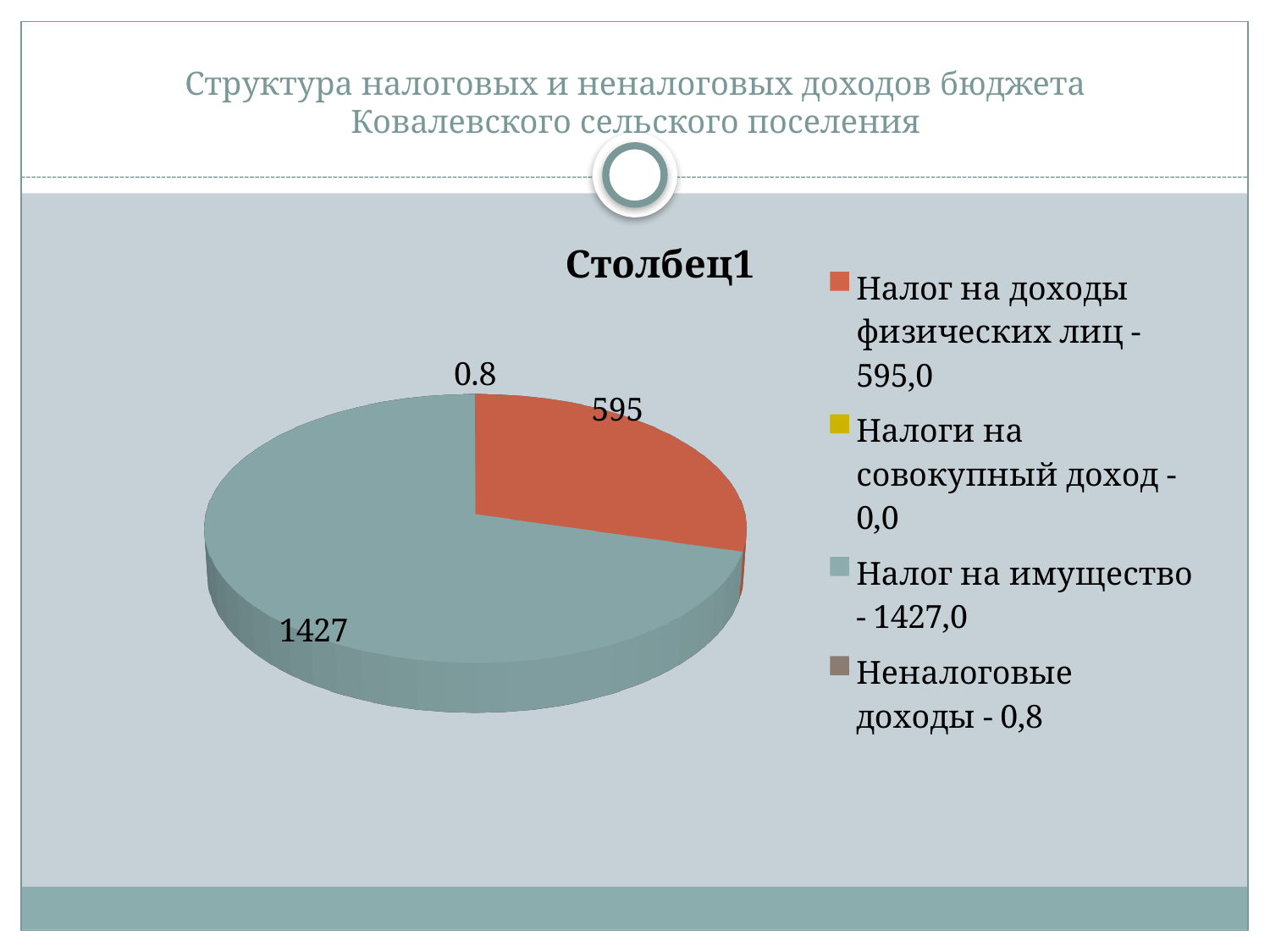
How many entries does the chart legend list? 4 Which category has the largest value? Налог на имущество What is the value for Налог на имущество? 1427,0 What is the value for Налог на доходы физических лиц? 595,0 What is the value for Налоги на совокупный доход? 0,0 Which category has the smallest value according to the legend? Налоги на совокупный доход What colour is the slice for Налог на доходы физических лиц? Red (orange-red) Which is larger: Налог на доходы физических лиц or Неналоговые доходы? Налог на доходы физических лиц What type of chart is shown on the slide? Pie chart What is the title of the chart? Столбец1 What is the difference between the values for Налог на имущество and Налог на доходы физических лиц? 832 What is the value for Неналоговые доходы? 0,8